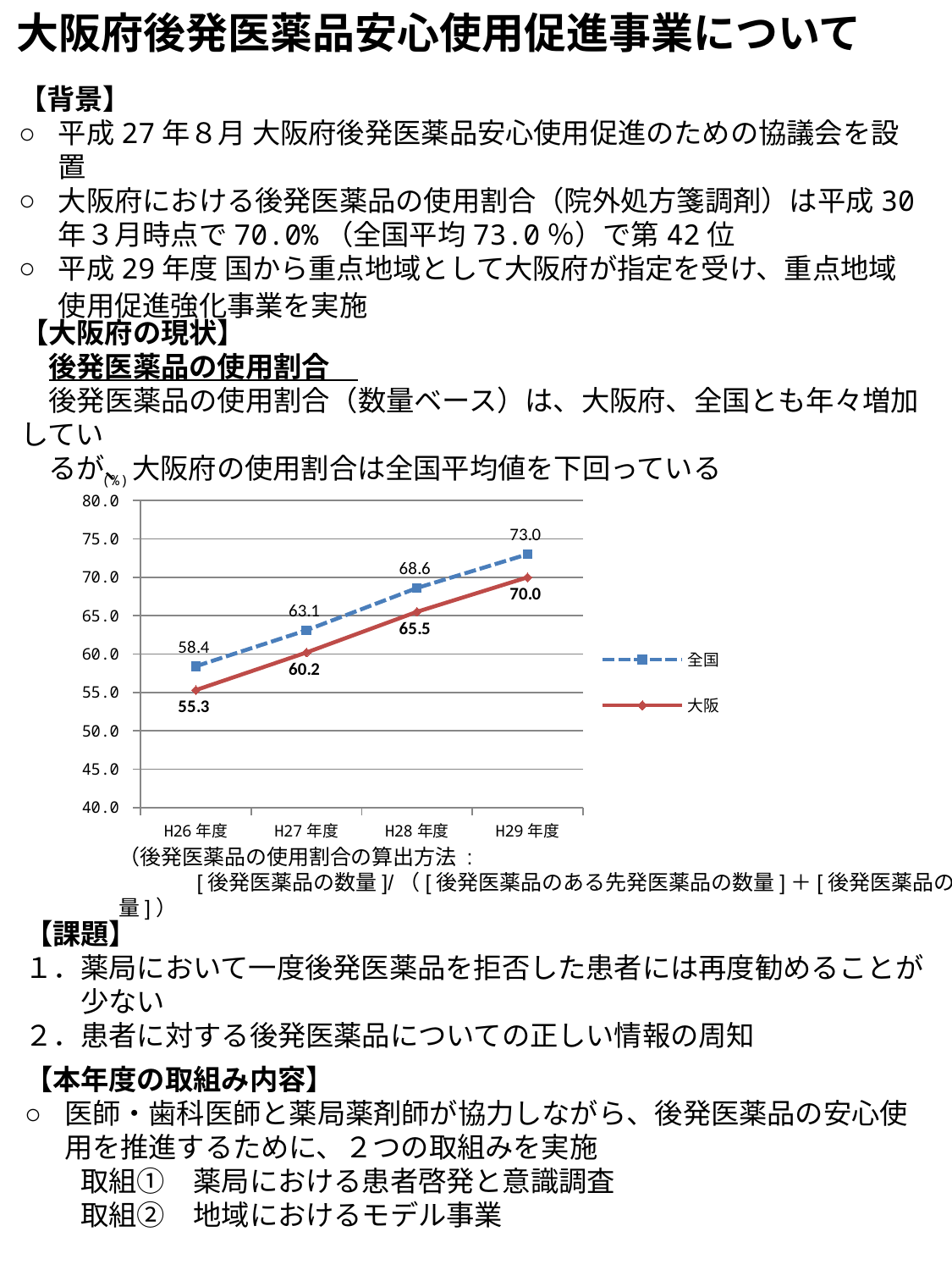
What is the difference between the 全国 and 大阪 values in H29年度? 3.0 In which fiscal year is the 大阪 value highest? H29年度 How many fiscal years are plotted on the x axis of the chart? 4 What is the value for 全国 in H29年度? 73.0 What is the value for 大阪 in H28年度? 65.5 How many series does the chart legend list? 2 What is the value for 大阪 in H26年度? 55.3 Which is larger in H27年度, the 全国 value or the 大阪 value? 全国 What is the value for 全国 in H27年度? 63.1 What type of chart is shown on the slide? line chart In which fiscal year is the 全国 value lowest? H26年度 Do the 大阪 values rise or fall from H26年度 to H29年度? rise